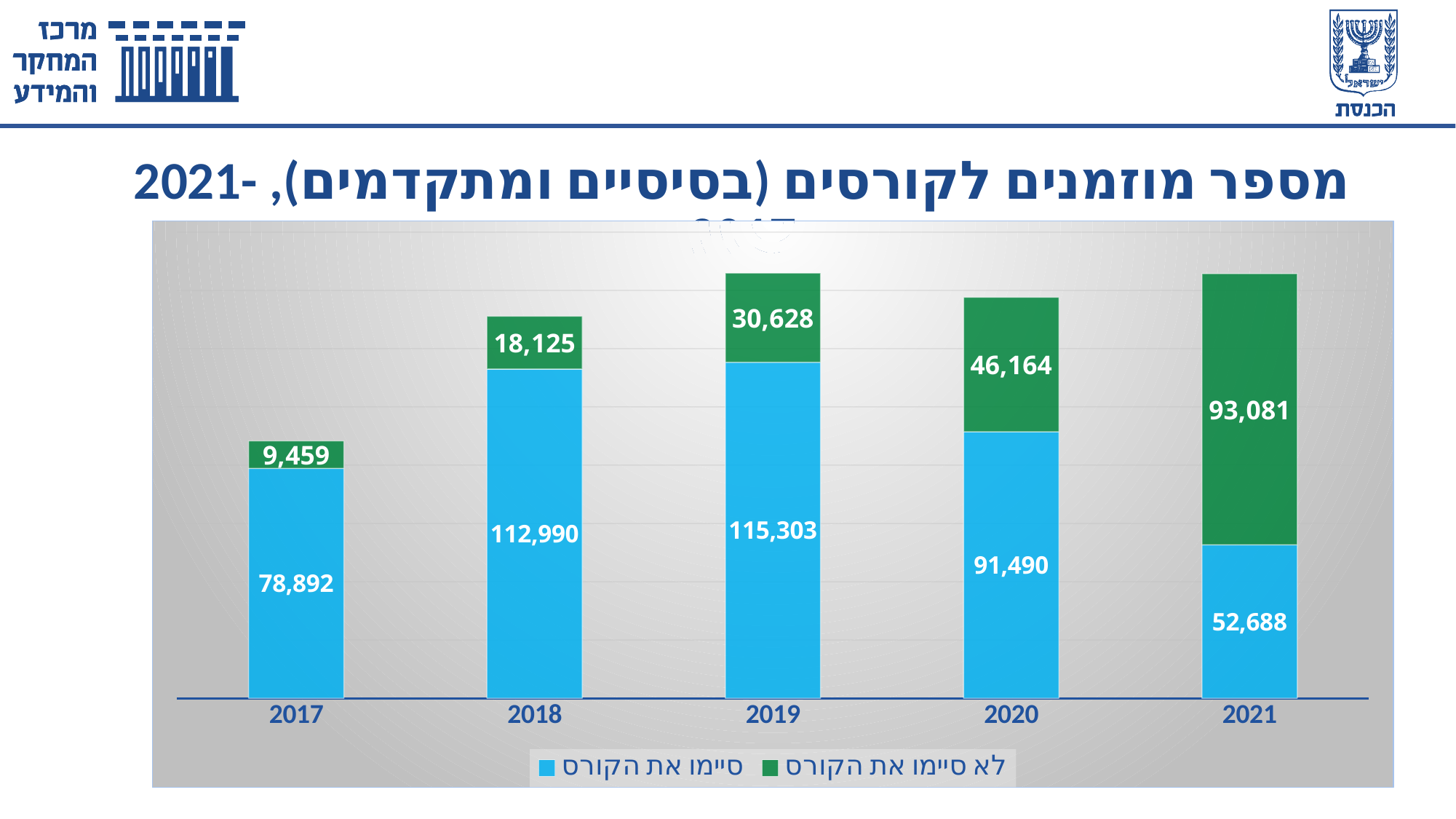
How many series does the legend list? 2 Does the value for לא סיימו את הקורס rise or fall from 2017 to 2021? rise What type of chart is shown on the slide? stacked bar chart What is the total of the stacked bar for 2020? 137,654 What is the value for סיימו את הקורס in 2017? 78,892 In which year is the value for לא סיימו את הקורס the highest? 2021 How many years are shown on the x axis? 5 What is the difference between the לא סיימו את הקורס values for 2020 and 2019? 15,536 In which year is the value for סיימו את הקורס the lowest? 2021 Which is larger in 2021: סיימו את הקורס or לא סיימו את הקורס? לא סיימו את הקורס What is the value for סיימו את הקורס in 2019? 115,303 What is the value for לא סיימו את הקורס in 2021? 93,081